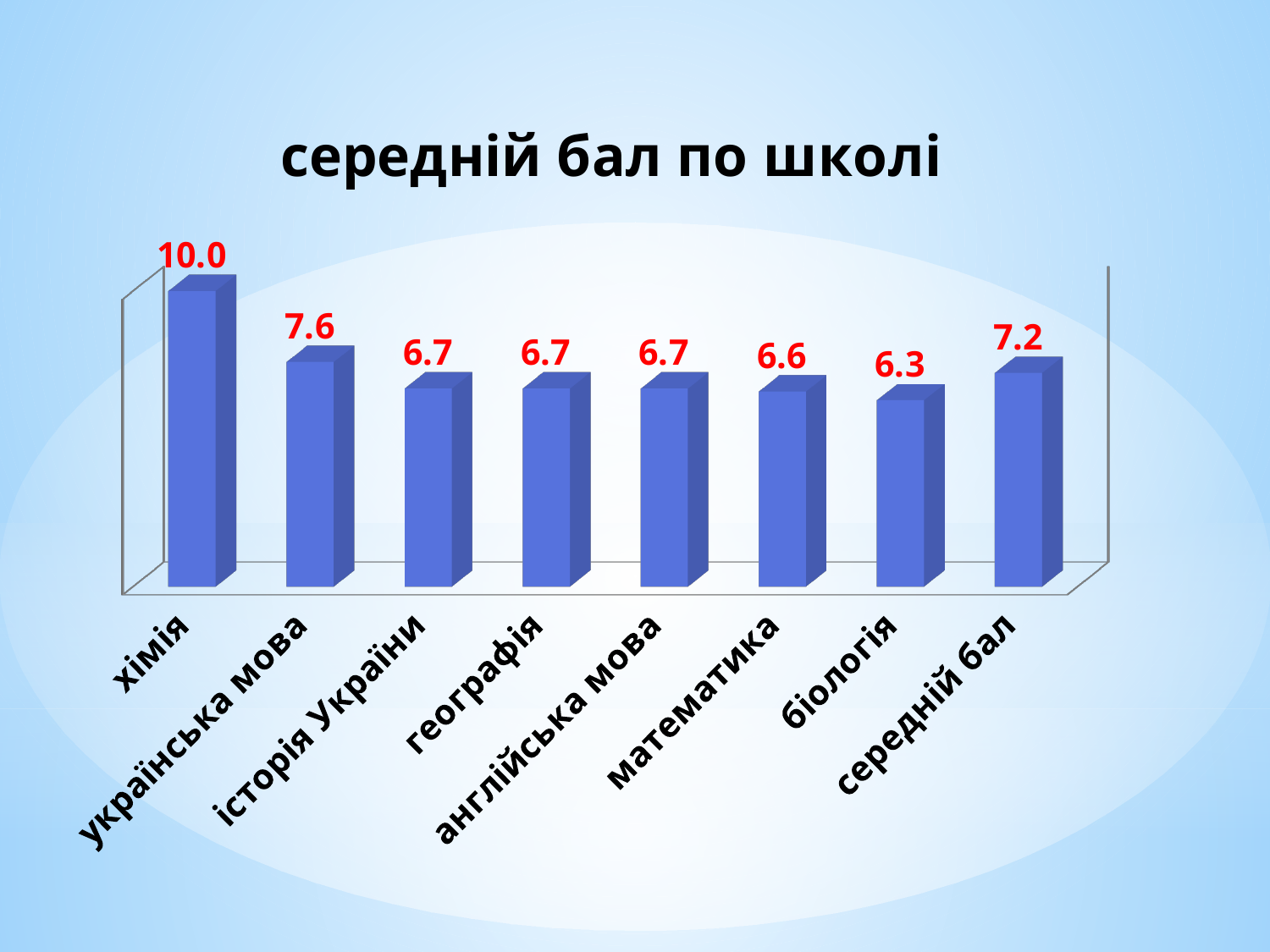
How many categories are shown on the chart? 8 What is the value for біологія? 6.3 Which category has the lowest value? біологія What is the value for середній бал? 7.2 Which is larger, the value for географія or the value for біологія? географія What kind of chart is shown on the slide? bar chart What is the value for українська мова? 7.6 What is the title of the chart? середній бал по школі What is the difference between the values for хімія and українська мова? 2.4 What is the value for математика? 6.6 Which category has the highest value? хімія What is the value for хімія? 10.0